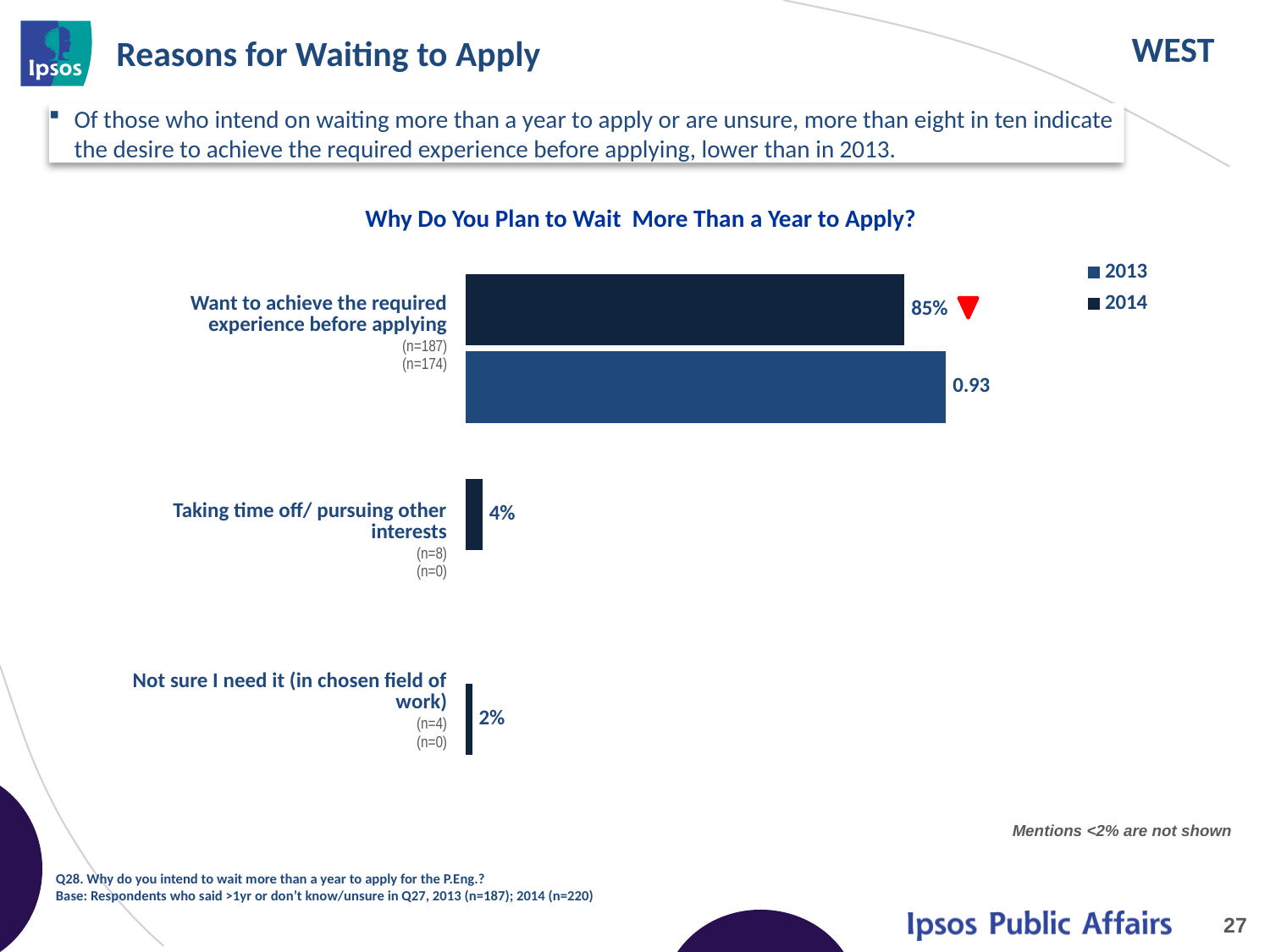
Which years are listed in the chart legend? 2013 and 2014 What kind of chart is shown on the slide? Bar chart Which category has the highest value in the chart? Want to achieve the required experience before applying How many series does the chart legend list? 2 What is the value shown for 'Not sure I need it (in chosen field of work)'? 2% What is the 2013 value label shown for 'Want to achieve the required experience before applying'? 0.93 What is the 2014 value for 'Want to achieve the required experience before applying'? 85% Which category has the lowest value in the chart? Not sure I need it (in chosen field of work) How many categories are shown in the chart? 3 What is the difference between the values for 'Taking time off/ pursuing other interests' and 'Not sure I need it (in chosen field of work)'? 2% What is the value shown for 'Taking time off/ pursuing other interests'? 4% What is the title of the chart? Why Do You Plan to Wait More Than a Year to Apply?